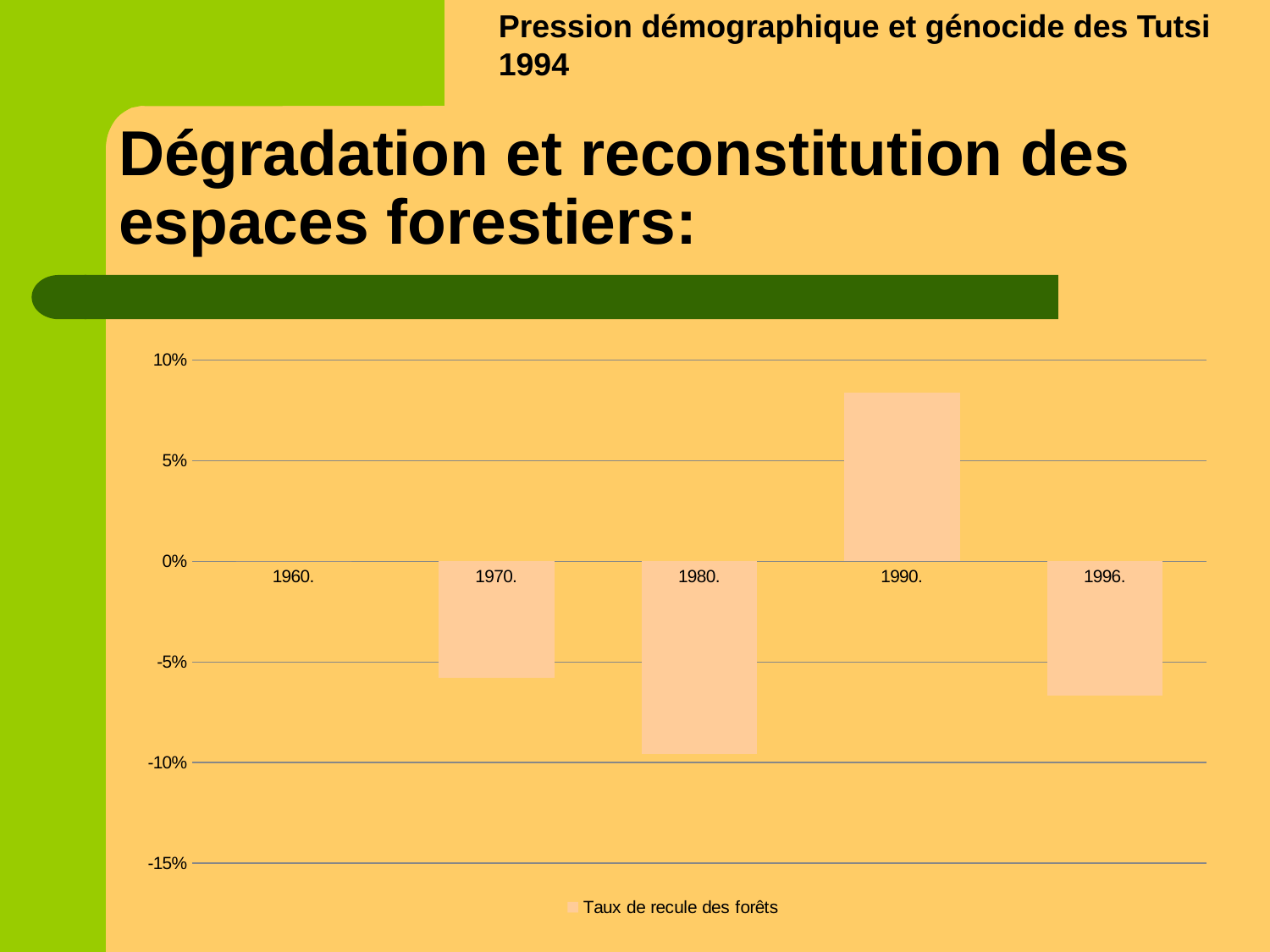
Is the value for 1980 greater or less than -5%? less How many series does the chart legend list? 1 How many categories (years) are shown on the x axis of the chart? 5 Which has the larger value, 1990 or 1996? 1990. What is the name of the series shown in the chart legend? Taux de recule des forêts Which has the larger value, 1970 or 1980? 1970. Which year has the highest value in the chart? 1990. Is the value for 1990 greater or less than 10%? less Is the value for 1996 greater or less than -5%? less What kind of chart is shown on the slide? bar chart Which year has the lowest value in the chart? 1980.